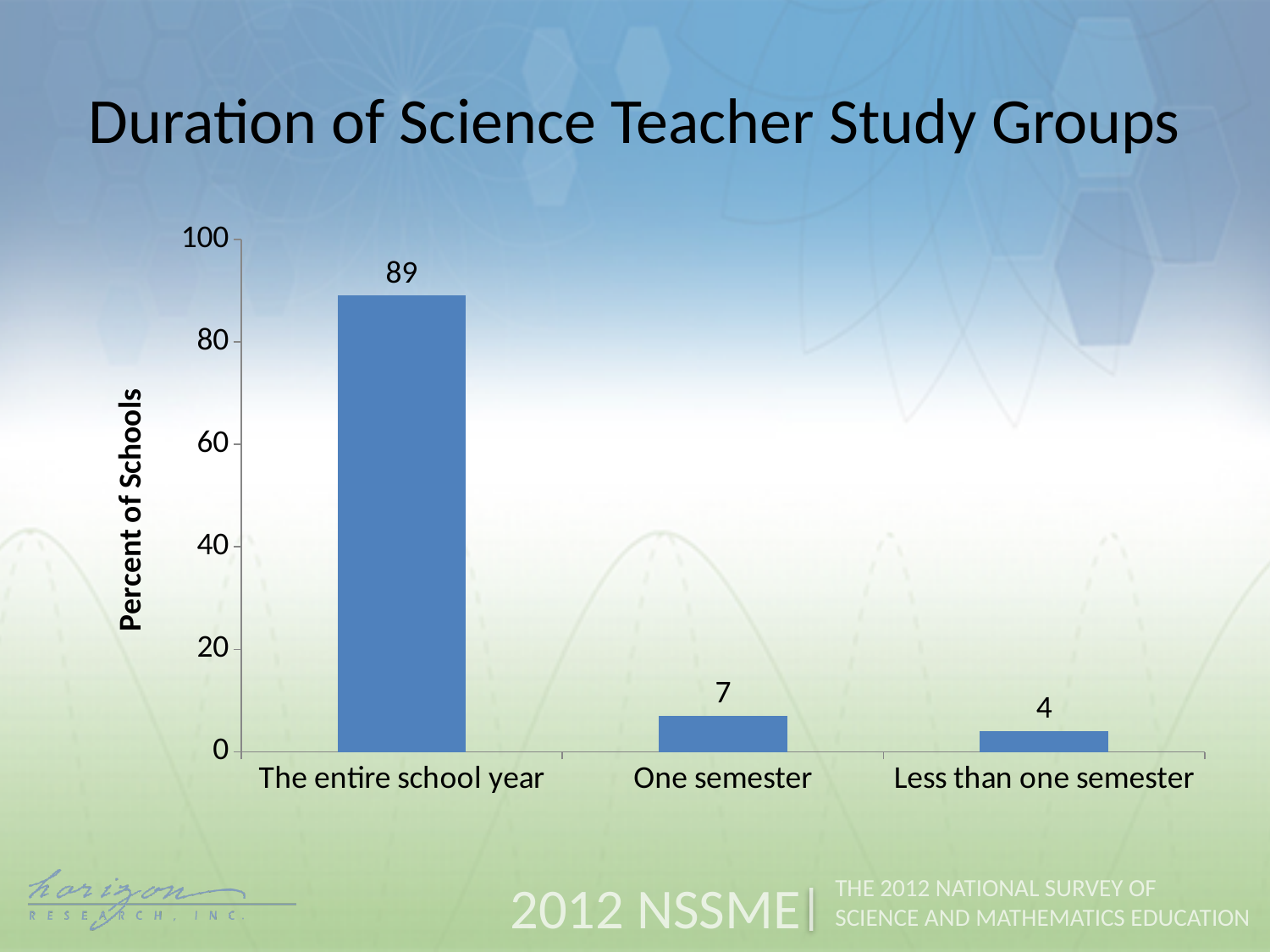
Is the value for The entire school year greater or less than 80? greater Which category has the lowest percent of schools? Less than one semester What percent of schools have science teacher study groups lasting the entire school year? 89 What is the difference between the values for One semester and Less than one semester? 3 What kind of chart is shown on the slide? Bar chart What is the value for One semester? 7 What is the difference between the values for The entire school year and One semester? 82 Which category has the highest percent of schools? The entire school year What is the label of the vertical axis? Percent of Schools How many categories are shown on the x axis? 3 What is the value for Less than one semester? 4 Which is larger, the value for One semester or Less than one semester? One semester